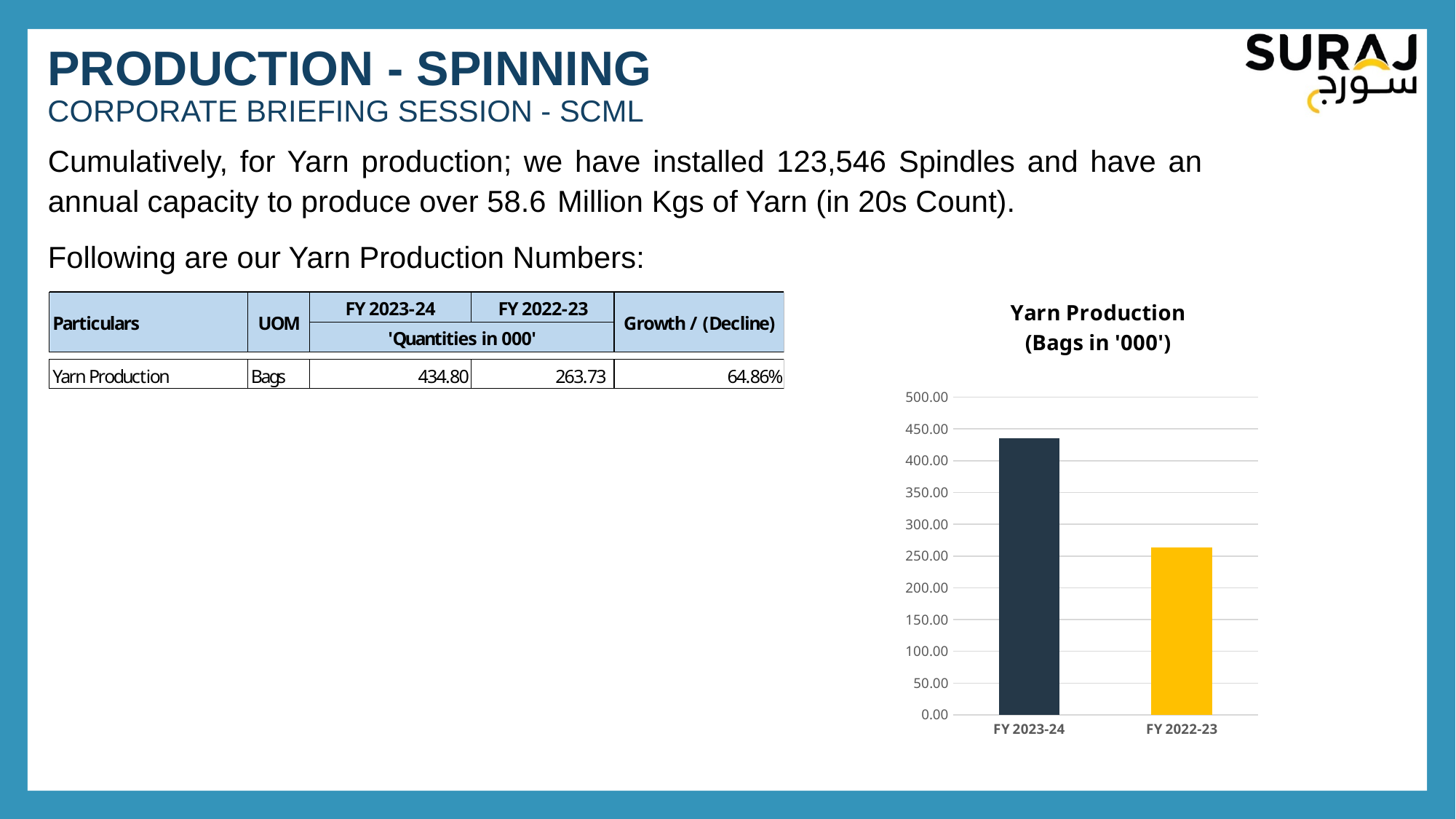
How many bars does the chart show? 2 Is the yarn production for FY 2023-24 greater or less than 450.00? less According to the table, what is the yarn production for FY 2023-24 (in '000 bags)? 434.80 Which fiscal year has the lower yarn production in the chart? FY 2022-23 Is the yarn production for FY 2022-23 greater or less than 250.00? greater Is the yarn production for FY 2023-24 greater or less than 400.00? greater Which fiscal year has the higher yarn production in the chart? FY 2023-24 What kind of chart is shown on the slide? bar chart According to the table, what is the yarn production for FY 2022-23 (in '000 bags)? 263.73 Does yarn production rise or fall from FY 2023-24 to FY 2022-23 along the x axis? fall What is the title of the chart? Yarn Production (Bags in '000')